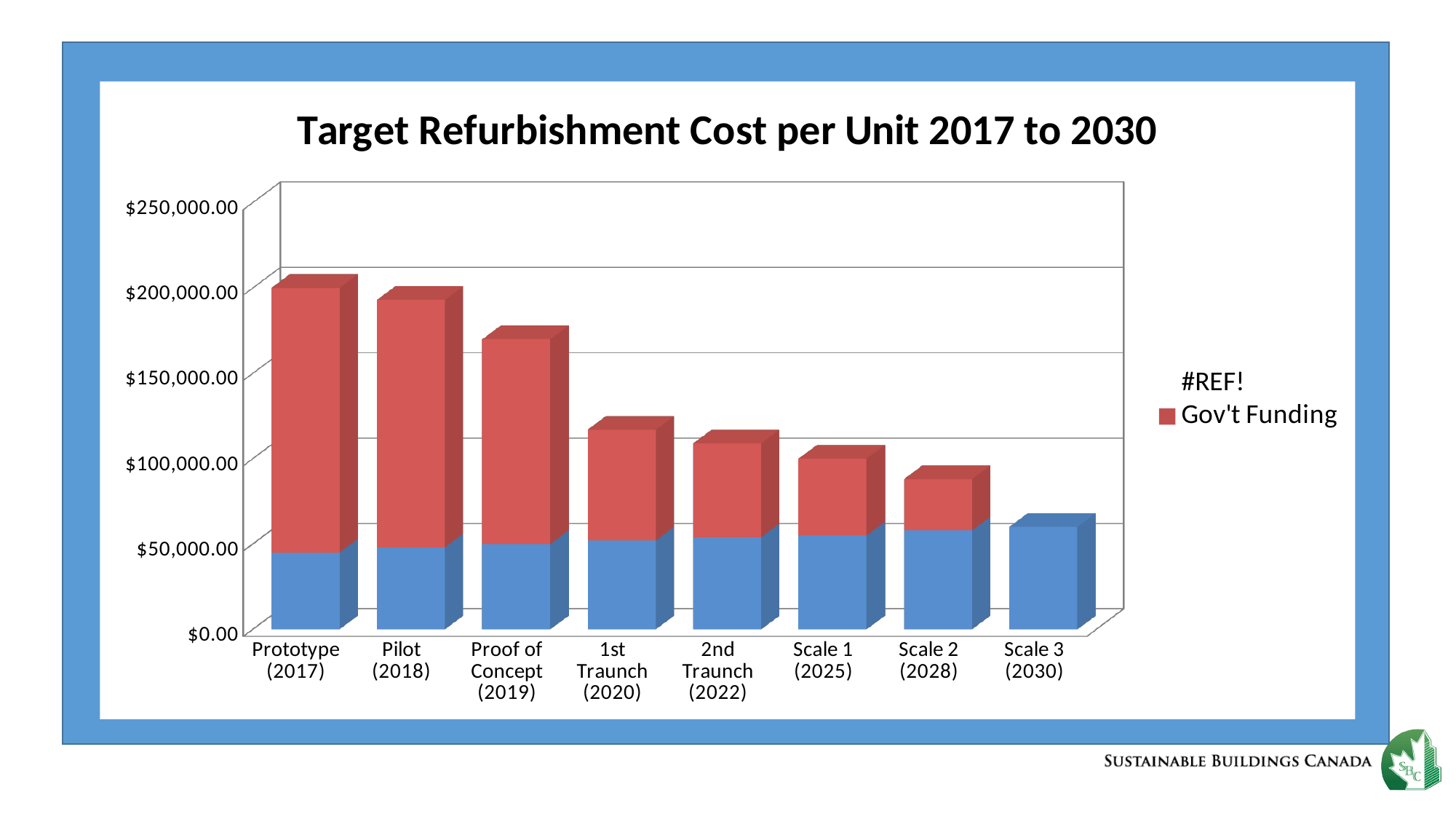
Do the total bar heights rise or fall from Prototype (2017) to Scale 3 (2030)? fall Which category has the lowest total bar in the chart? Scale 3 (2030) What is the title of the chart? Target Refurbishment Cost per Unit 2017 to 2030 Which is larger, the total bar for Pilot (2018) or the total bar for Scale 1 (2025)? Pilot (2018) Which legend entry is shown with a red marker in the chart? Gov't Funding What kind of chart is shown on the slide? stacked bar chart Is the total bar for Proof of Concept (2019) greater or less than $150,000.00? greater Is the total bar for Scale 2 (2028) greater or less than $100,000.00? less How many categories are shown along the x axis of the chart? 8 How many series does the chart's legend list? 2 Is the total bar for Scale 3 (2030) greater or less than $50,000.00? greater Which category has the highest total bar in the chart? Prototype (2017)